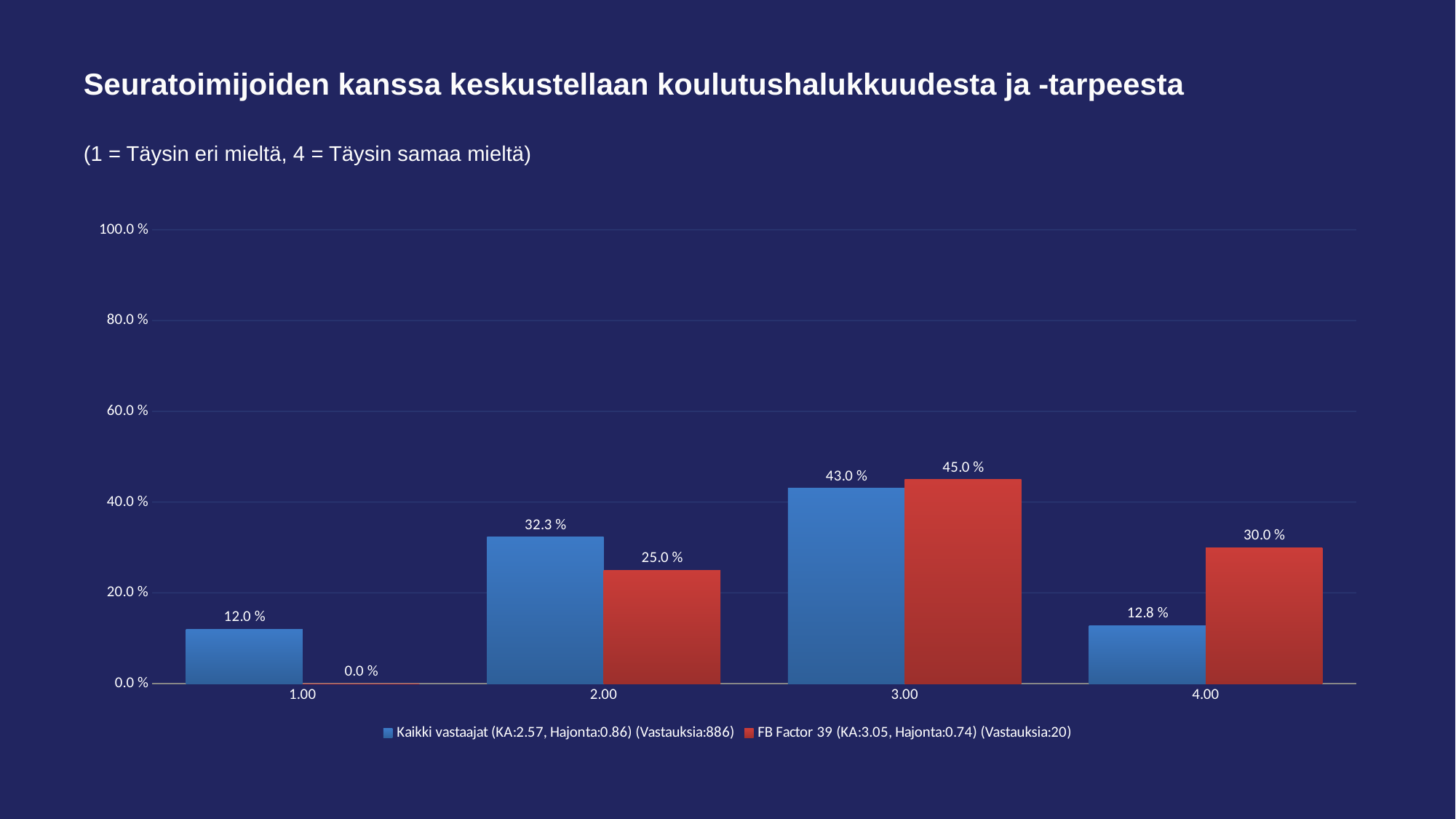
What kind of chart is shown on the slide? Bar chart What is the value for Kaikki vastaajat at category 2.00? 32.3 % What is the value for FB Factor 39 at category 1.00? 0.0 % What is the title of the chart? Seuratoimijoiden kanssa keskustellaan koulutushalukkuudesta ja -tarpeesta At category 4.00, which series has the larger value, Kaikki vastaajat or FB Factor 39? FB Factor 39 What is the value for FB Factor 39 at category 4.00? 30.0 % How many categories are shown on the x axis? 4 What is the difference between the FB Factor 39 and Kaikki vastaajat values at category 3.00? 2.0 % How many series does the legend list? 2 Is the value for Kaikki vastaajat at category 3.00 greater or less than 40.0 %? greater Which category has the highest value for Kaikki vastaajat? 3.00 Which category has the lowest value for FB Factor 39? 1.00